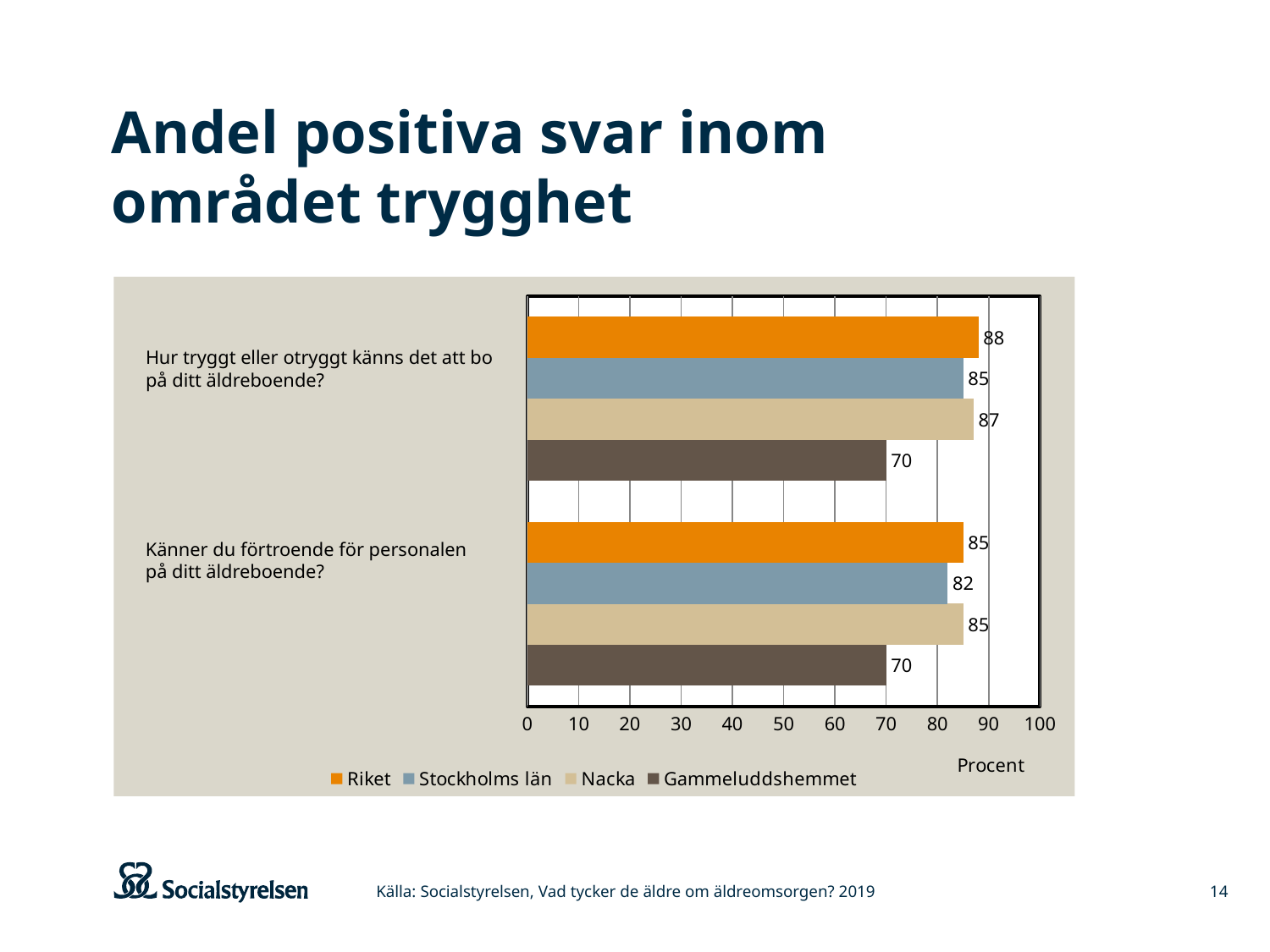
What is the value for Stockholms län for the question "Känner du förtroende för personalen på ditt äldreboende?"? 82 What is the label of the horizontal axis? Procent What is the value for Gammeluddshemmet for the question "Känner du förtroende för personalen på ditt äldreboende?"? 70 Which is larger for the question "Känner du förtroende för personalen på ditt äldreboende?": the value for Riket or the value for Stockholms län? Riket What kind of chart is shown on the slide? Bar chart Which series has the lowest value for the question "Hur tryggt eller otryggt känns det att bo på ditt äldreboende?"? Gammeluddshemmet What is the value for Nacka for the question "Hur tryggt eller otryggt känns det att bo på ditt äldreboende?"? 87 How many series does the legend list? 4 What is the difference between the Riket value and the Gammeluddshemmet value for the question "Hur tryggt eller otryggt känns det att bo på ditt äldreboende?"? 18 Is the value for Gammeluddshemmet for the question "Känner du förtroende för personalen på ditt äldreboende?" greater or less than 80? less Which series has the highest value for the question "Hur tryggt eller otryggt känns det att bo på ditt äldreboende?"? Riket What is the value for Riket for the question "Hur tryggt eller otryggt känns det att bo på ditt äldreboende?"? 88